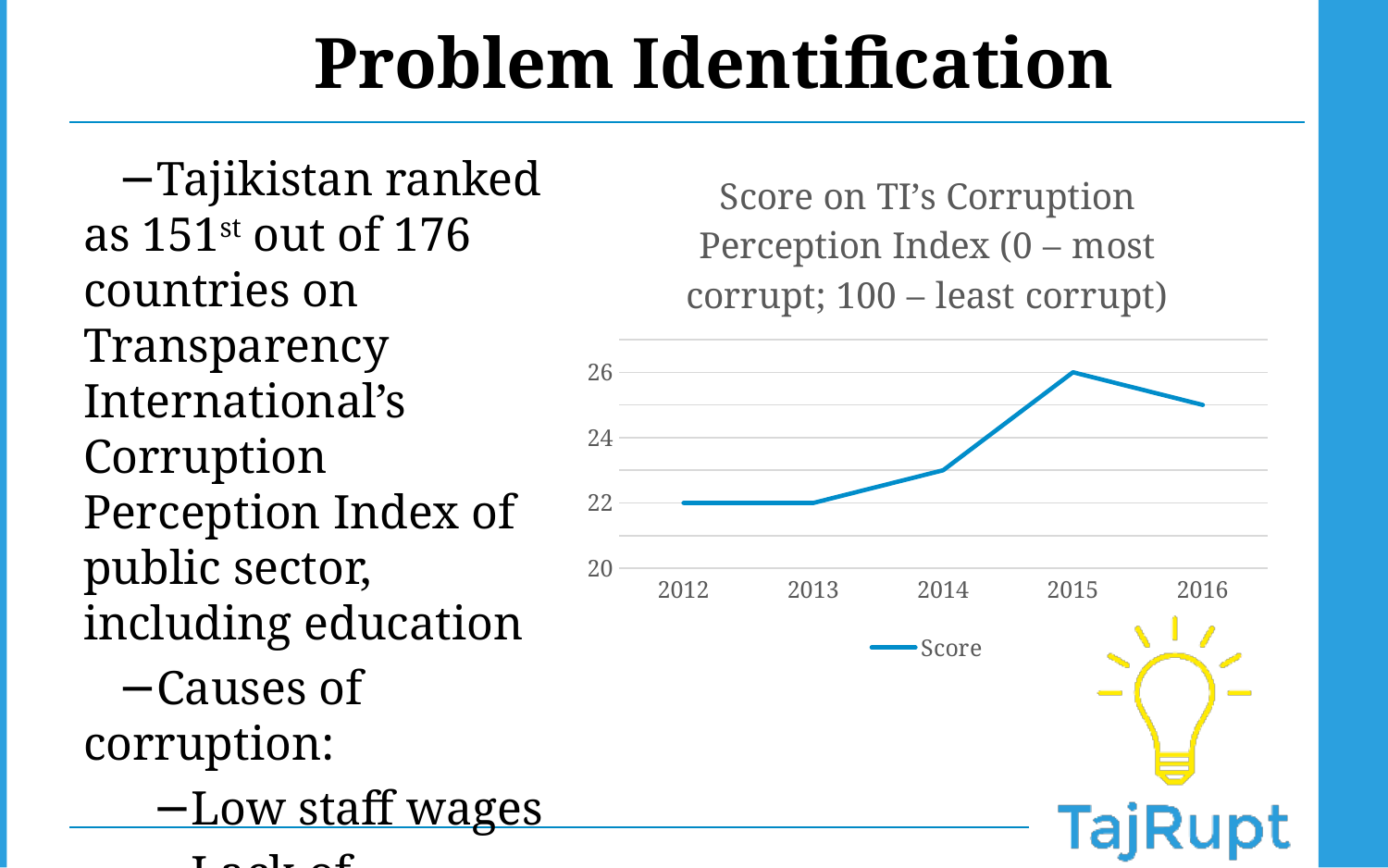
Is the Score for 2016 greater or less than 24? greater Does the Score rise or fall from 2013 to 2015? rise Is the Score for 2014 greater or less than 24? less Which year has the larger Score, 2015 or 2016? 2015 Which year has the highest Score? 2015 What is the difference between the Score in 2015 and the Score in 2012? 4 How many series does the chart's legend list? 1 How many years are plotted on the x axis of the chart? 5 What kind of chart is shown on the slide? line chart What is the Score for 2015? 26 What is the Score for 2012? 22 What is the name of the series shown in the chart's legend? Score